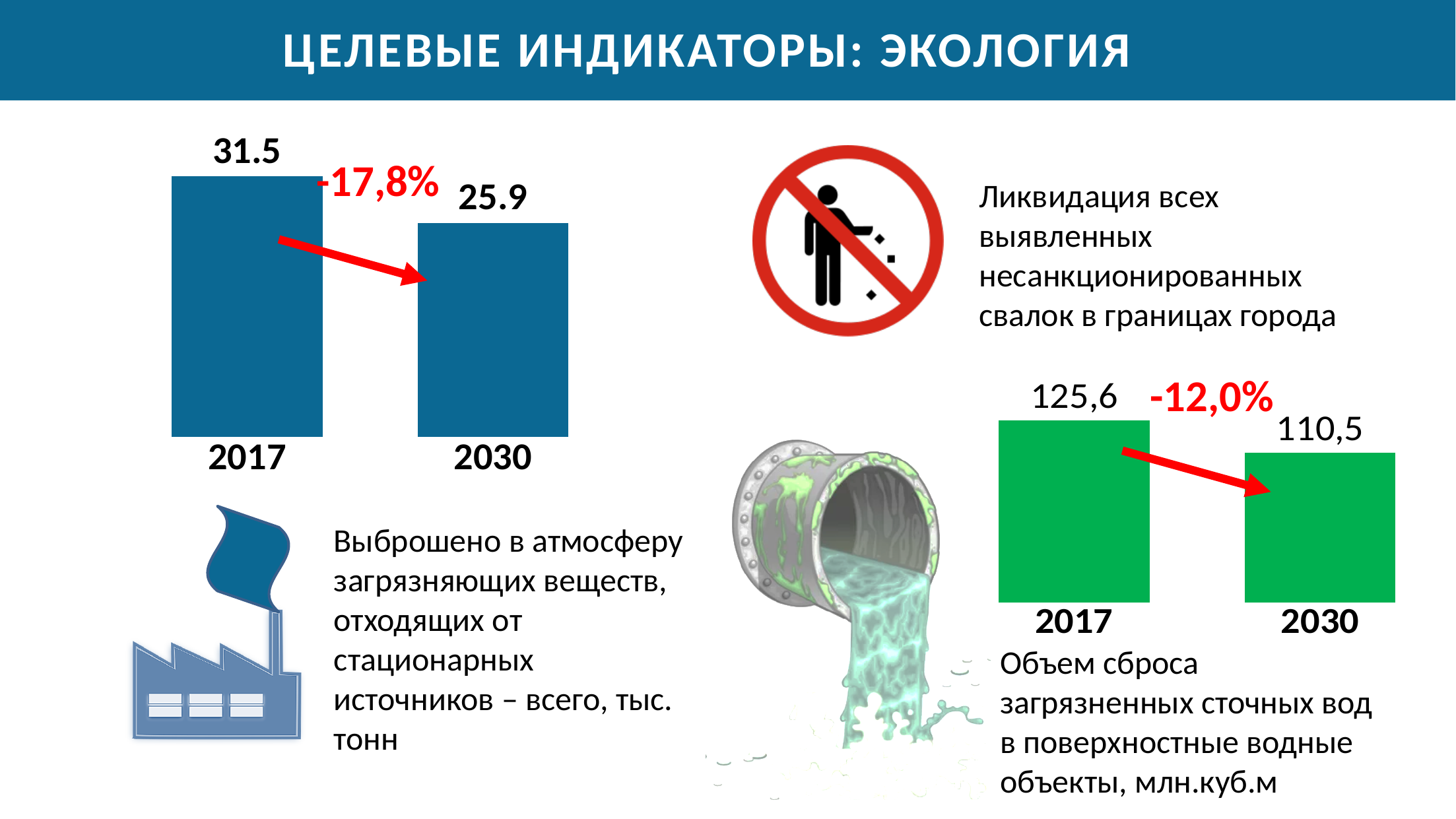
In the left chart (emissions into the atmosphere), what is the value for 2030? 25.9 What type of chart is the right chart? bar chart What percentage change is shown in red above the left chart? -17,8% In the right chart, what is the difference between the 2017 and 2030 values? 15,1 In the right chart, which year has the lower value? 2030 In the right chart, is the value for 2017 larger or smaller than the value for 2030? larger In the left chart, which year has the higher value? 2017 In the left chart, what is the difference between the 2017 and 2030 values? 5.6 In the left chart (emissions into the atmosphere), what is the value for 2017? 31.5 In the right chart (discharge of polluted wastewater), what is the value for 2017? 125,6 In the right chart (discharge of polluted wastewater), what is the value for 2030? 110,5 How many bars does the left chart have? 2